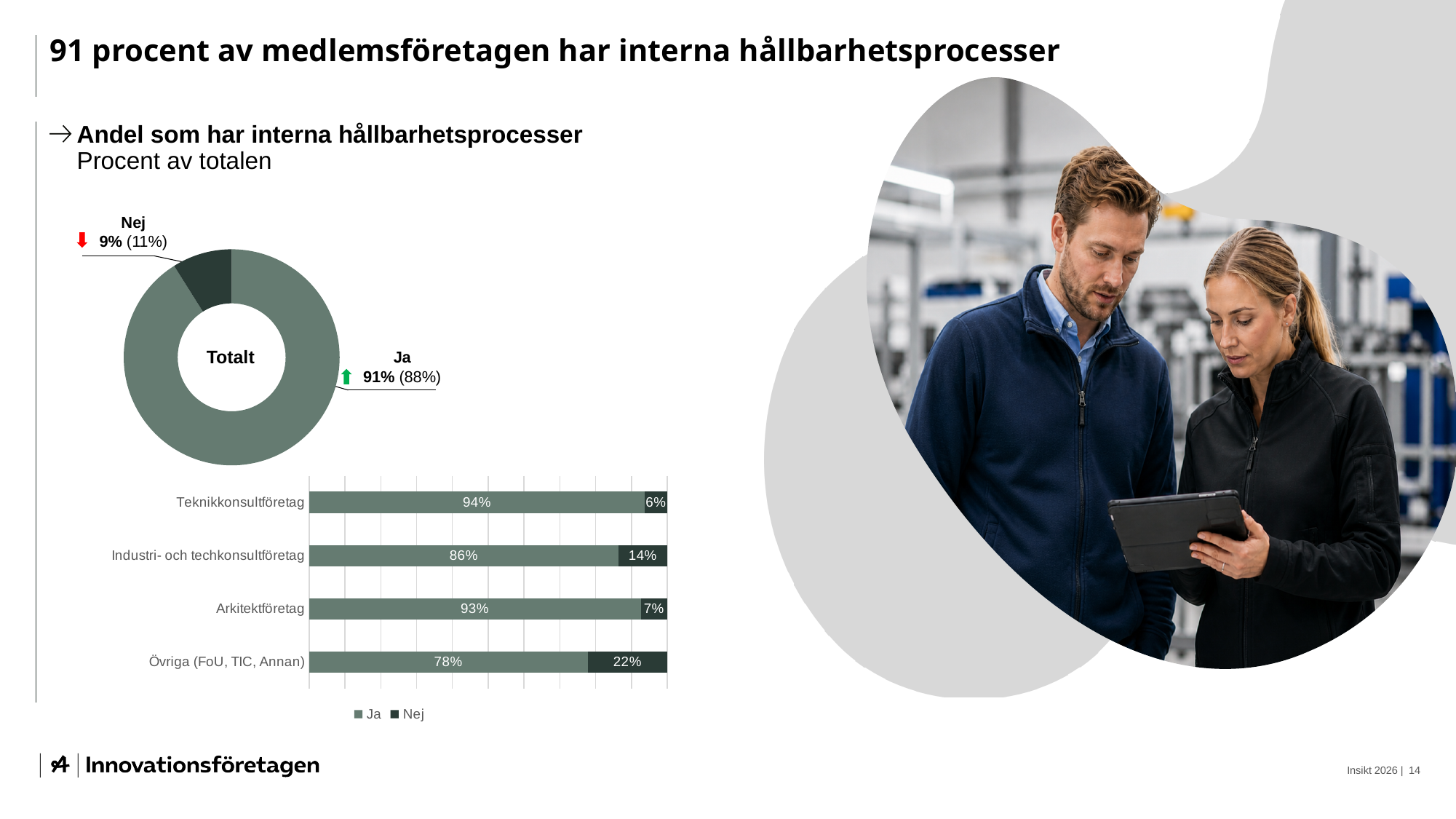
In the bar chart by company type, what is the difference between the Ja values for Arkitektföretag and Industri- och techkonsultföretag? 7% In the bar chart by company type, which category has the lowest Ja value? Övriga (FoU, TIC, Annan) In the bar chart by company type, which has a larger Nej value, Industri- och techkonsultföretag or Arkitektföretag? Industri- och techkonsultföretag In the bar chart by company type, what is the Nej value for Övriga (FoU, TIC, Annan)? 22% How many series does the legend of the bar chart by company type list? 2 In the donut chart labelled Totalt, what share answered Ja? 91% How many categories are shown in the bar chart by company type? 4 What type of chart is the chart labelled Totalt? Donut chart In the bar chart by company type, which category has the highest Ja value? Teknikkonsultföretag In the bar chart by company type, what is the Ja value for Teknikkonsultföretag? 94% In the donut chart labelled Totalt, what share answered Nej? 9% In the donut chart labelled Totalt, what is the previous value shown in parentheses next to Ja? 88%